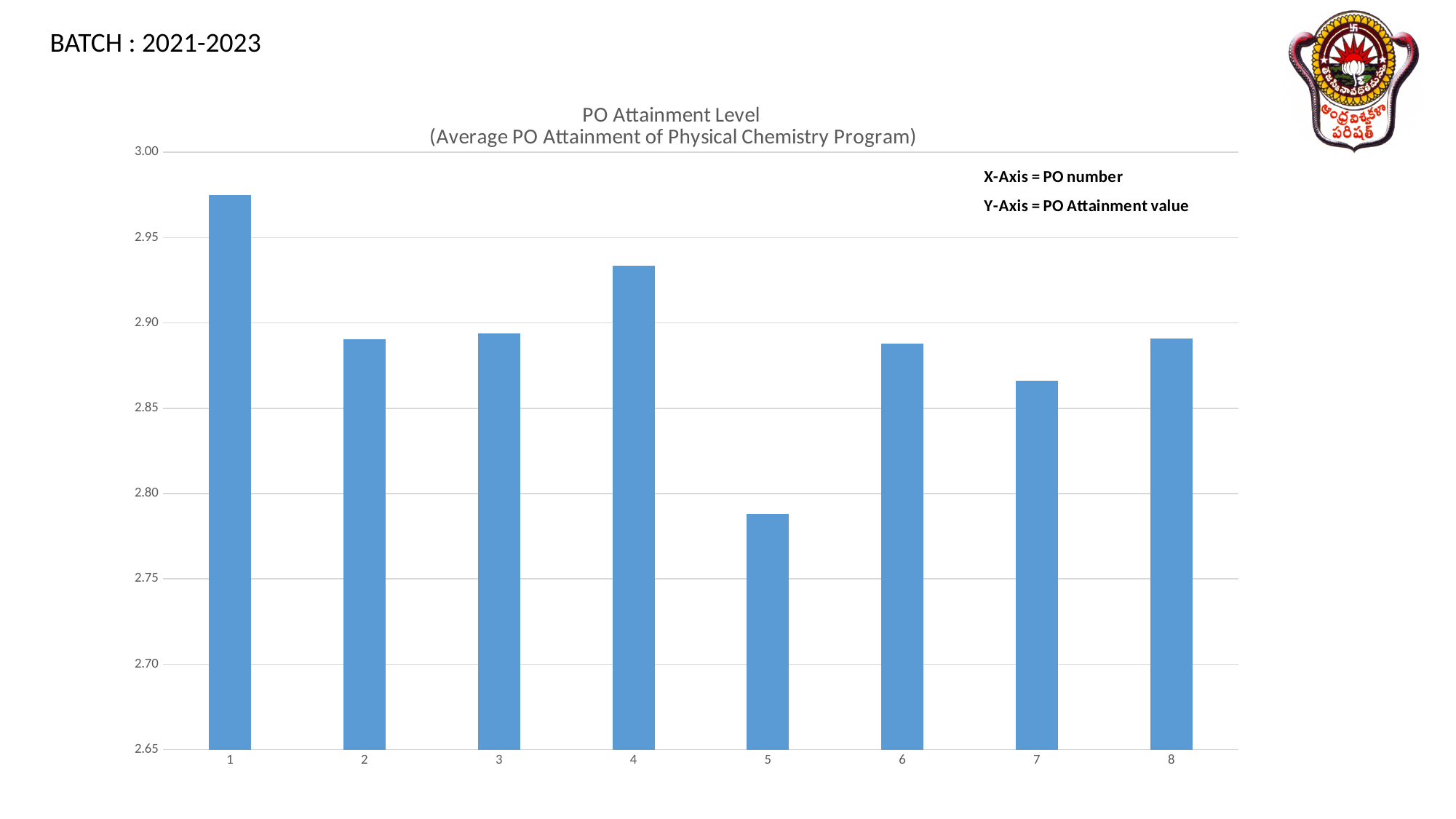
What is the title of the chart? PO Attainment Level (Average PO Attainment of Physical Chemistry Program) Is the attainment value for PO 1 greater or less than 2.95? greater Which has a higher attainment value, PO 5 or PO 7? PO 7 Which PO number has the lowest attainment value? 5 Is the attainment value for PO 7 greater or less than 2.85? greater Which PO number has the highest attainment value? 1 According to the note on the chart, what does the Y-Axis represent? PO Attainment value Is the attainment value for PO 4 greater or less than 2.90? greater Which has a higher attainment value, PO 1 or PO 4? PO 1 How many PO numbers are plotted on the x axis? 8 What kind of chart is shown on the slide? bar chart